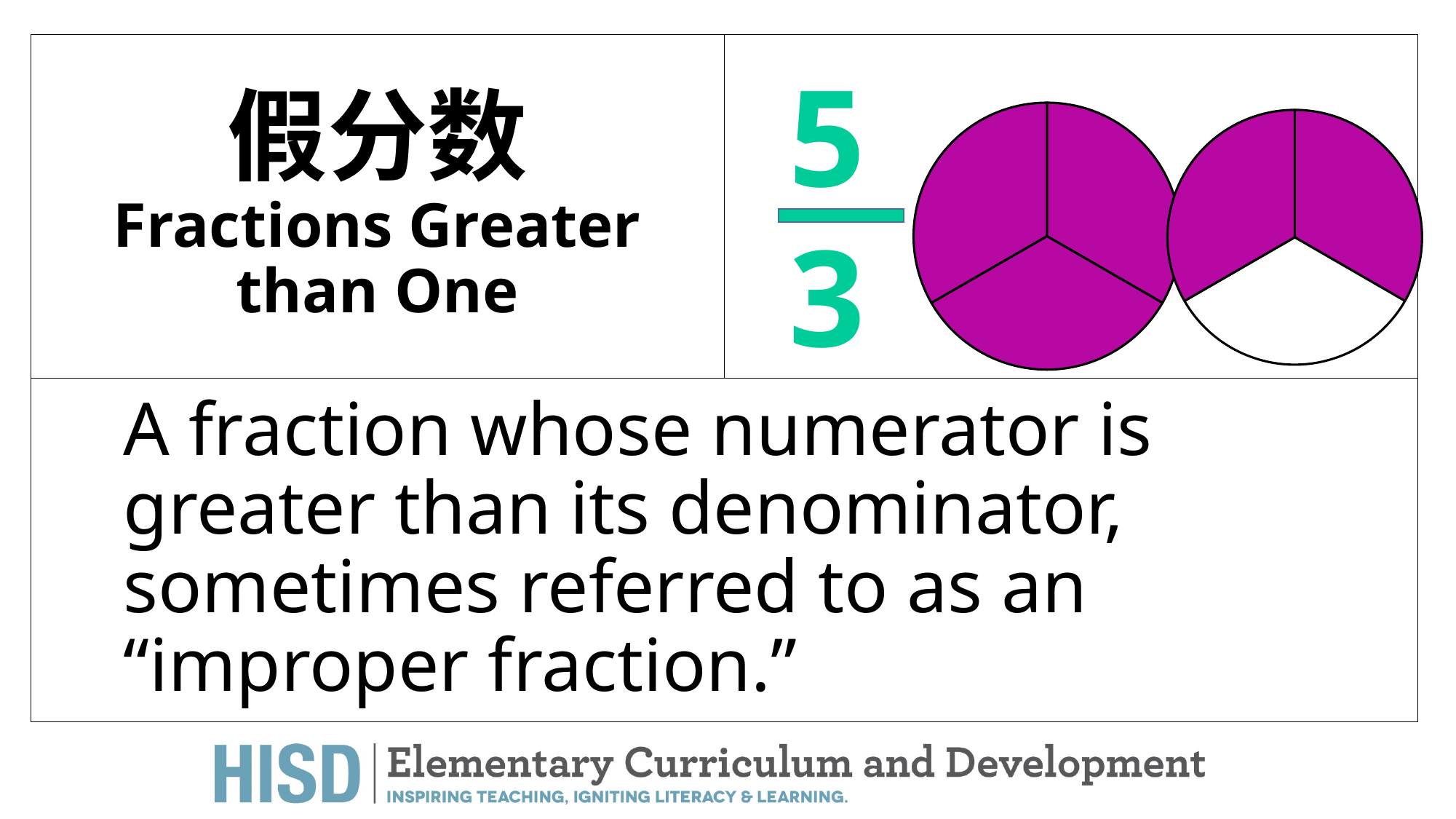
What fraction is shown next to the two circle diagrams? 5/3 How many parts of the right-hand circle are shaded? 2 How many circles are drawn on the slide? 2 What is the numerator of the fraction shown beside the circles? 5 Which circle has more shaded parts, the left one or the right one? the left one What colour are the shaded parts of the circles? purple How many parts in total are shaded purple across both circles? 5 What is the denominator of the fraction shown beside the circles? 3 What share of the left-hand circle is shaded? 3/3 (the whole circle)